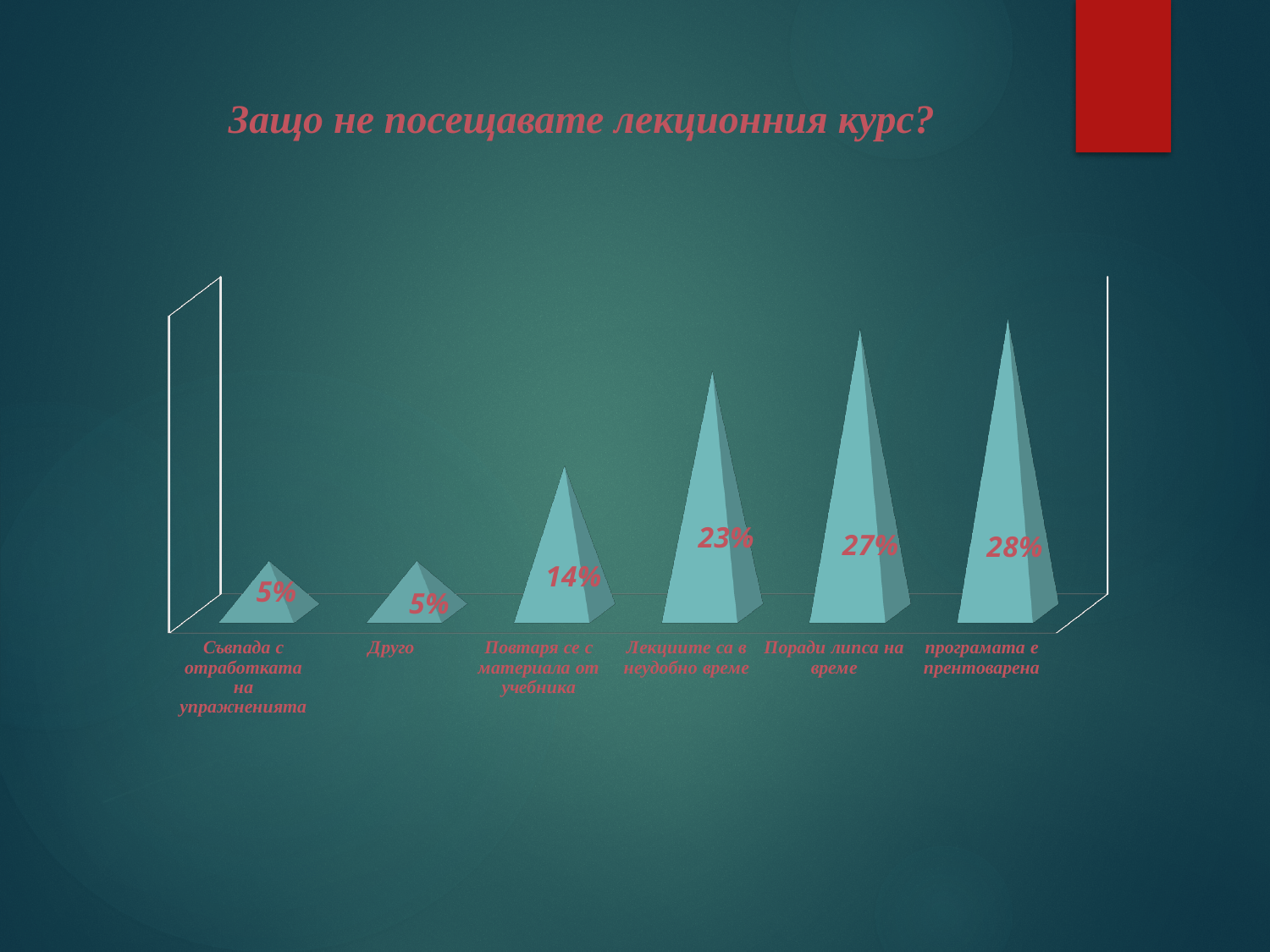
What is the value for "Повтаря се с материала от учебника"? 14% What is the value for "Лекциите са в неудобно време"? 23% What is the value for "Друго"? 5% Which category has the highest value? програмата е прентоварена How many categories are shown in the chart? 6 What is the value for "Поради липса на време"? 27% What is the title of the chart? Защо не посещавате лекционния курс? What is the difference between the values for "програмата е прентоварена" and "Лекциите са в неудобно време"? 5% What kind of chart is shown on the slide? bar chart Which is larger, the value for "Лекциите са в неудобно време" or the value for "Повтаря се с материала от учебника"? Лекциите са в неудобно време Do the values rise or fall from left to right along the x axis? rise What is the difference between the values for "Поради липса на време" and "Повтаря се с материала от учебника"? 13%